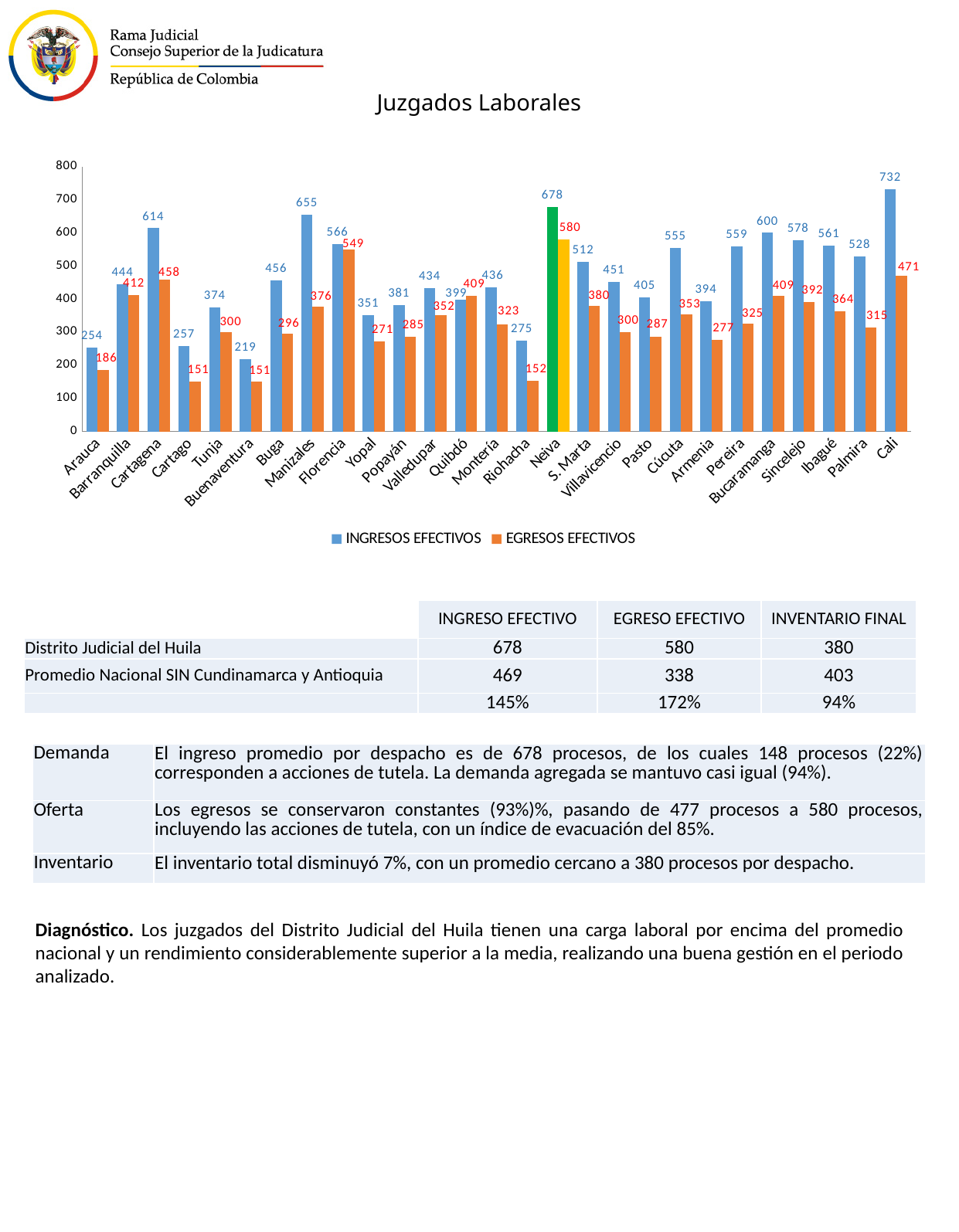
Which city has the lowest INGRESOS EFECTIVOS value? Buenaventura Which city has the highest INGRESOS EFECTIVOS value? Cali How many series does the chart legend list? 2 Which is larger: the INGRESOS EFECTIVOS value for Cartagena or for Bucaramanga? Cartagena How many cities are shown on the x axis of the chart? 27 Which city has the highest EGRESOS EFECTIVOS value? Neiva What is the INGRESOS EFECTIVOS value for Manizales? 655 What is the INGRESOS EFECTIVOS value for Neiva? 678 What is the title of the chart? Juzgados Laborales What is the EGRESOS EFECTIVOS value for Florencia? 549 What is the difference between INGRESOS EFECTIVOS and EGRESOS EFECTIVOS for Neiva? 98 What type of chart is shown on the slide? bar chart